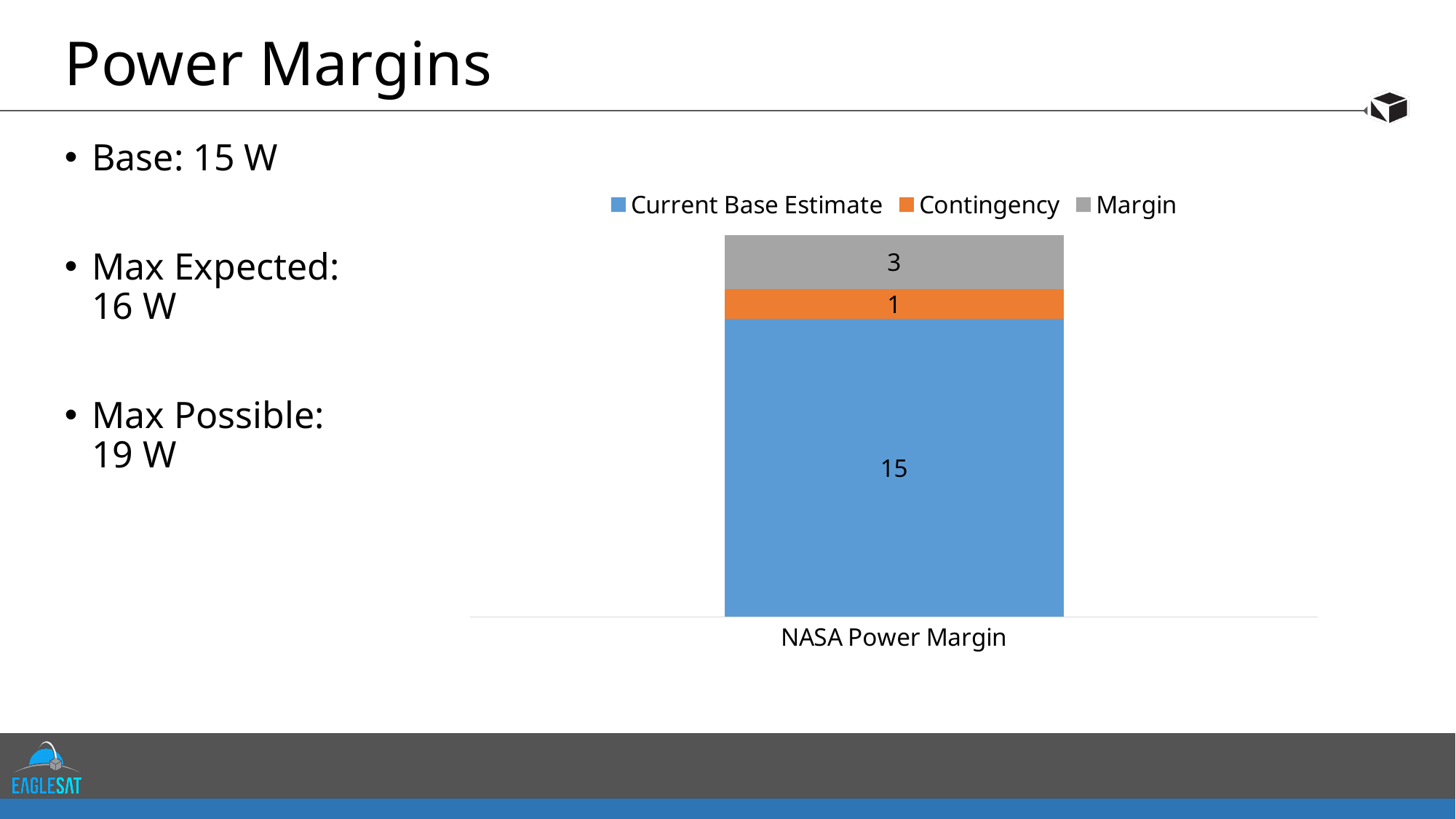
Which series has the largest segment in the NASA Power Margin bar? Current Base Estimate What is the value of the Margin segment in the NASA Power Margin bar? 3 What is the total of the NASA Power Margin stacked bar? 19 What is the value of the Contingency segment in the NASA Power Margin bar? 1 What is the value of the Current Base Estimate segment in the NASA Power Margin bar? 15 What colour is the Contingency series in the chart? Orange Which is larger, the Margin segment or the Contingency segment? Margin Which series has the smallest segment in the NASA Power Margin bar? Contingency How many series does the legend list? 3 What kind of chart is shown on the slide? Stacked bar chart What is the difference between the Current Base Estimate and Margin segments? 12 How many categories are shown on the x axis? 1